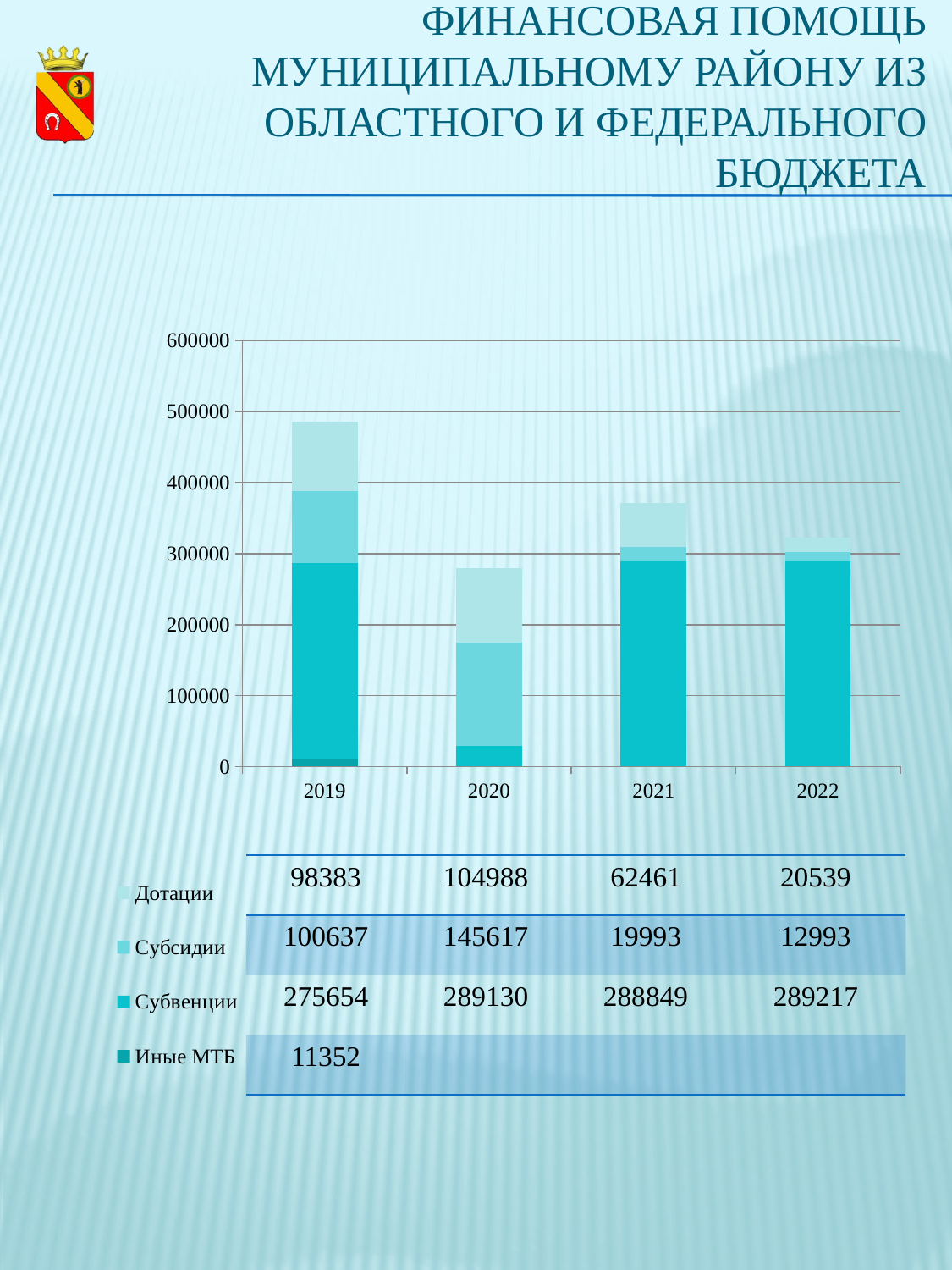
What is the value of Иные МТБ for 2019? 11352 What is the value of Дотации for 2019? 98383 What kind of chart is shown on the slide? stacked bar chart What is the value of Субвенции for 2022? 289217 What is the difference between Дотации in 2019 and in 2021? 35922 In which year is Субсидии highest? 2020 In which year is Дотации lowest? 2022 How many series does the legend list? 4 What is the value of Субсидии for 2020? 145617 Which is larger: Субвенции in 2019 or Субвенции in 2021? Субвенции in 2021 What is the total of the stacked bar for 2022? 322749 Is the total height of the 2019 bar greater or less than 400000? greater